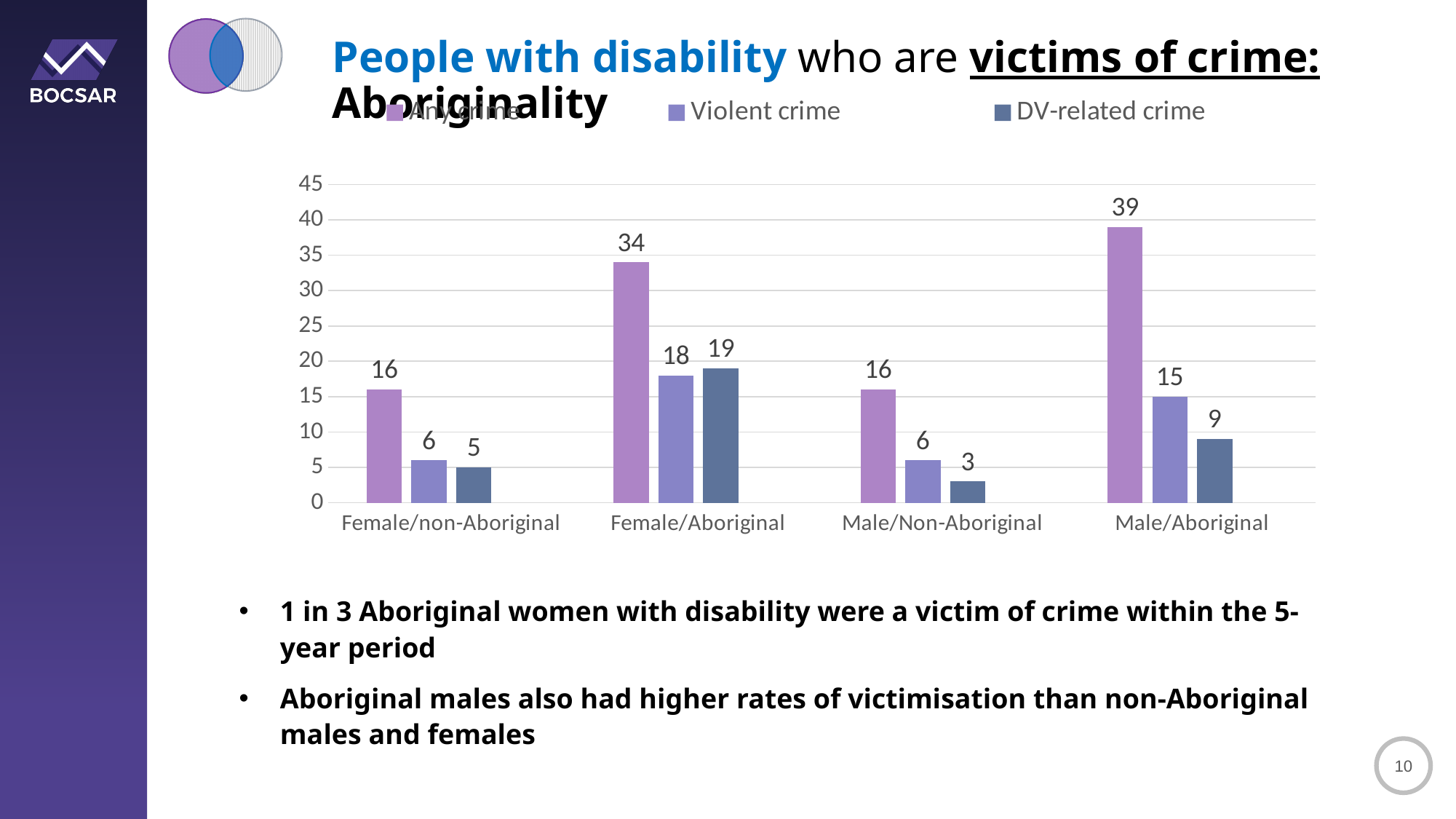
What is the value for Violent crime in the Male/Aboriginal category? 15 What is the difference between the Any crime values for Male/Aboriginal and Female/Aboriginal? 5 What is the value for DV-related crime in the Male/Non-Aboriginal category? 3 Which series is shown in the darkest blue-grey colour? DV-related crime What is the value for Any crime in the Female/Aboriginal category? 34 Which category has the highest value for Any crime? Male/Aboriginal Which category has the lowest value for DV-related crime? Male/Non-Aboriginal How many categories are shown on the x axis? 4 Is the Any crime value for Male/Aboriginal greater or less than 35? greater Which is larger: the DV-related crime value for Female/Aboriginal or for Male/Aboriginal? Female/Aboriginal What kind of chart is shown on the slide? Bar chart How many series does the legend list? 3